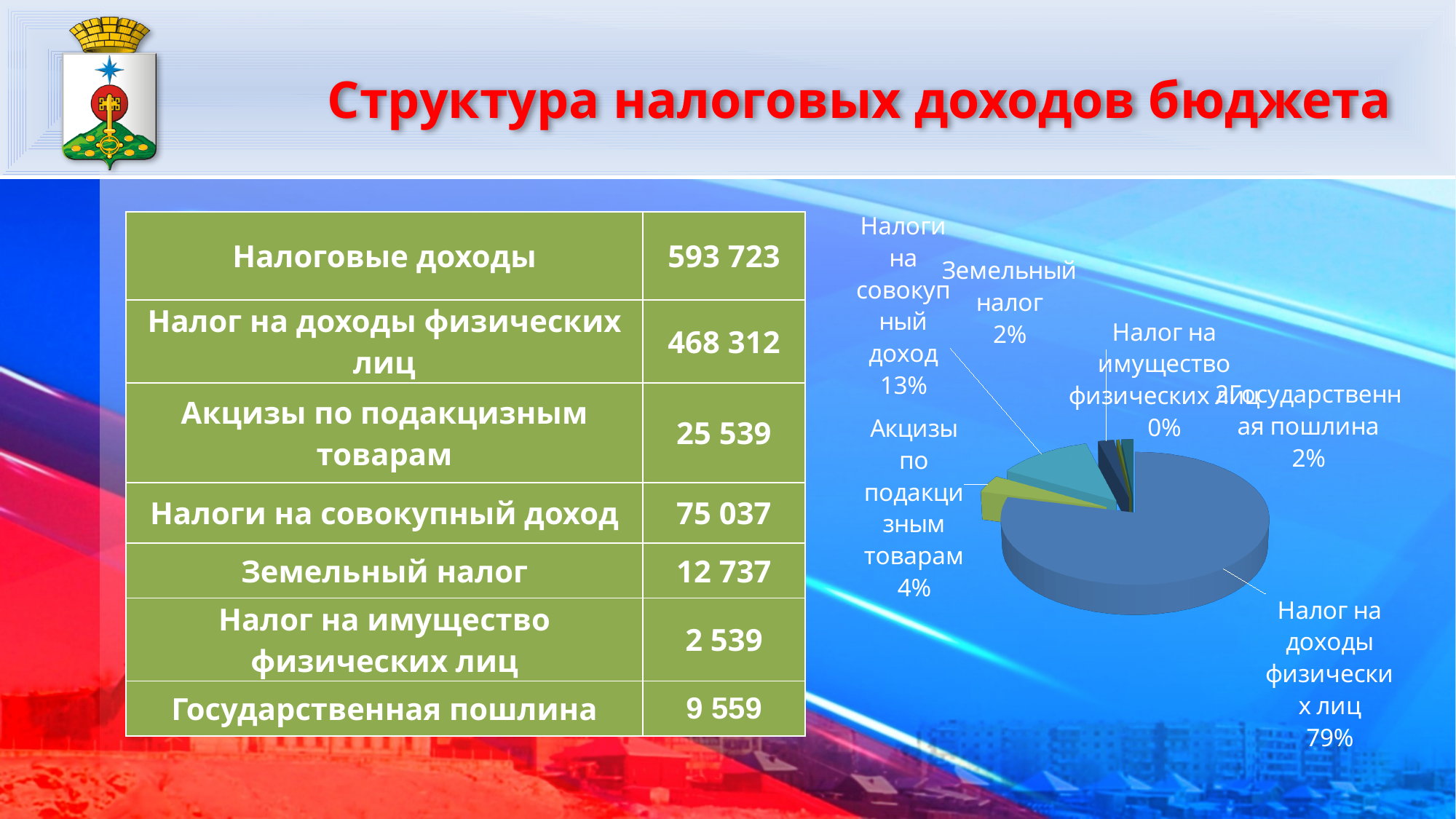
Which slice of the pie chart is the largest? Налог на доходы физических лиц What share of the pie chart does "Налог на доходы физических лиц" have? 79% What is the difference in percentage points between the shares of "Налог на доходы физических лиц" and "Налоги на совокупный доход" in the pie chart? 66 Which has the larger share in the pie chart, "Налоги на совокупный доход" or "Акцизы по подакцизным товарам"? Налоги на совокупный доход How many slices does the pie chart have? 6 What share of the pie chart does "Налоги на совокупный доход" have? 13% What share of the pie chart does "Акцизы по подакцизным товарам" have? 4% Which slice of the pie chart is the smallest? Налог на имущество физических лиц What kind of chart is shown on the slide? pie chart